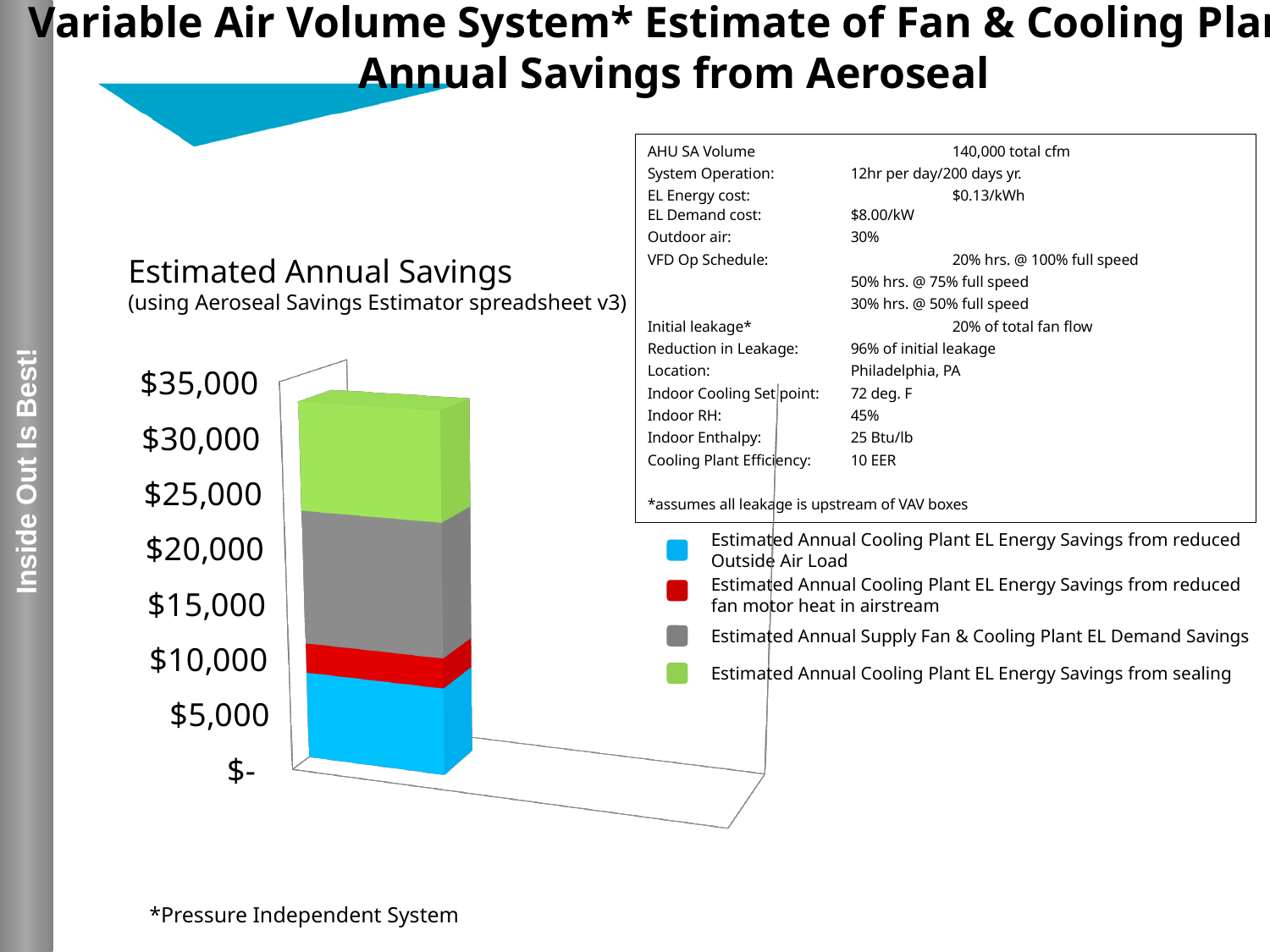
What is the highest value labelled on the chart's vertical axis? $35,000 Which is larger: the Estimated Annual Supply Fan & Cooling Plant EL Demand Savings segment or the reduced fan motor heat in airstream segment? Estimated Annual Supply Fan & Cooling Plant EL Demand Savings How many bars are plotted in the chart? 1 Is the total height of the stacked bar greater or less than $35,000? less What kind of chart is shown on the slide? stacked bar chart Which is larger: the reduced Outside Air Load segment or the reduced fan motor heat in airstream segment? Estimated Annual Cooling Plant EL Energy Savings from reduced Outside Air Load What is the title of the chart? Estimated Annual Savings Is the total height of the stacked bar greater or less than $30,000? greater How many series does the chart legend list? 4 Which series is the smallest segment of the stacked bar? Estimated Annual Cooling Plant EL Energy Savings from reduced fan motor heat in airstream What colour represents Estimated Annual Cooling Plant EL Energy Savings from sealing in the chart? green